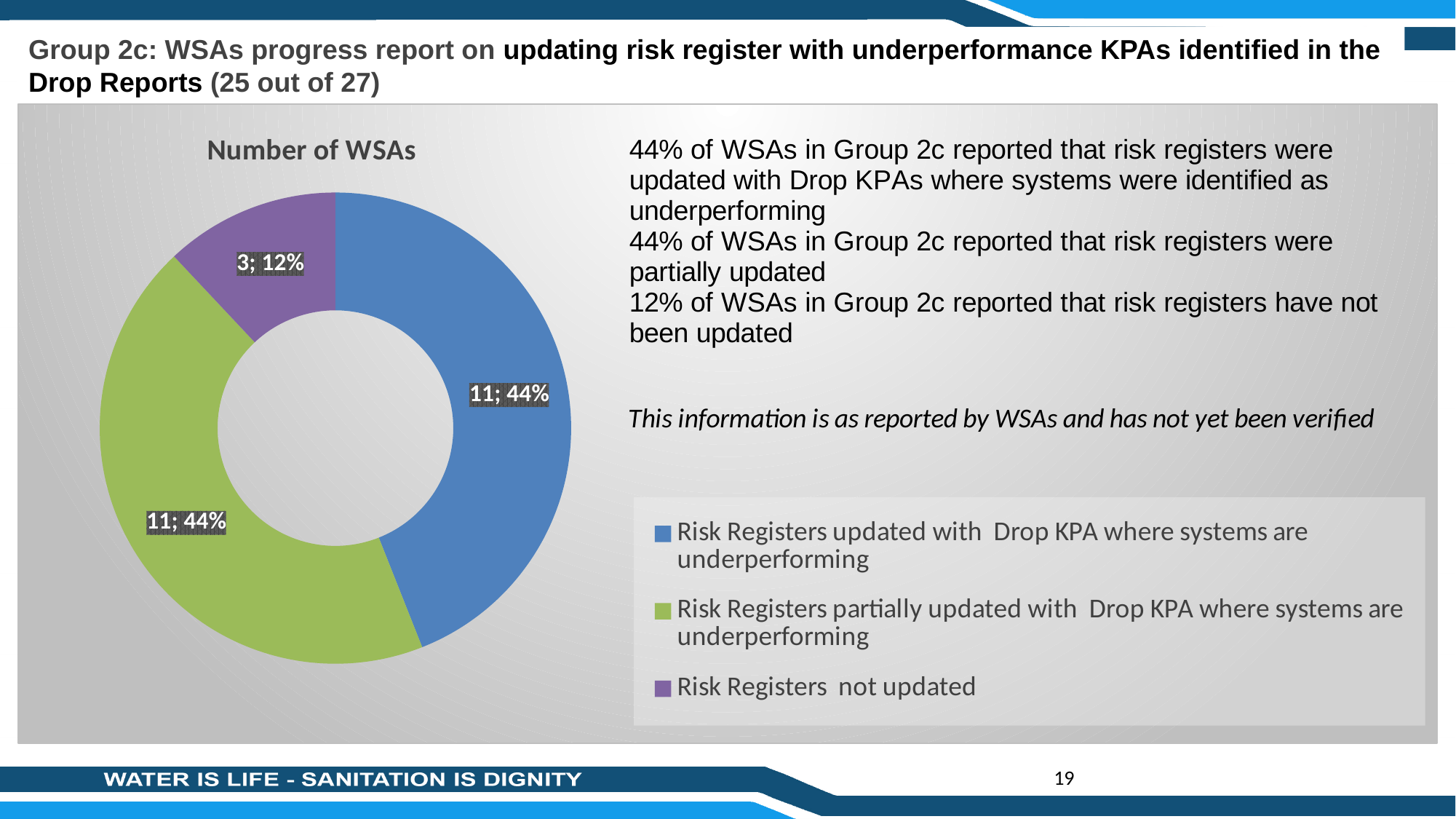
Which category has the smallest slice in the chart? Risk Registers not updated What kind of chart is shown on the slide? Doughnut (pie) chart How many WSAs reported Risk Registers updated with Drop KPA where systems are underperforming? 11 What share of the chart is the 'Risk Registers not updated' slice? 12% How many WSAs reported that Risk Registers were not updated? 3 Which is larger: the number of WSAs with Risk Registers partially updated or the number with Risk Registers not updated? Risk Registers partially updated What is the title of the chart? Number of WSAs How many entries does the legend list? 3 What is the difference between the number of WSAs with Risk Registers updated and the number with Risk Registers not updated? 8 What share of the chart is the 'Risk Registers partially updated with Drop KPA where systems are underperforming' slice? 44% What colour is the 'Risk Registers not updated' slice? Purple How many categories does the chart show? 3